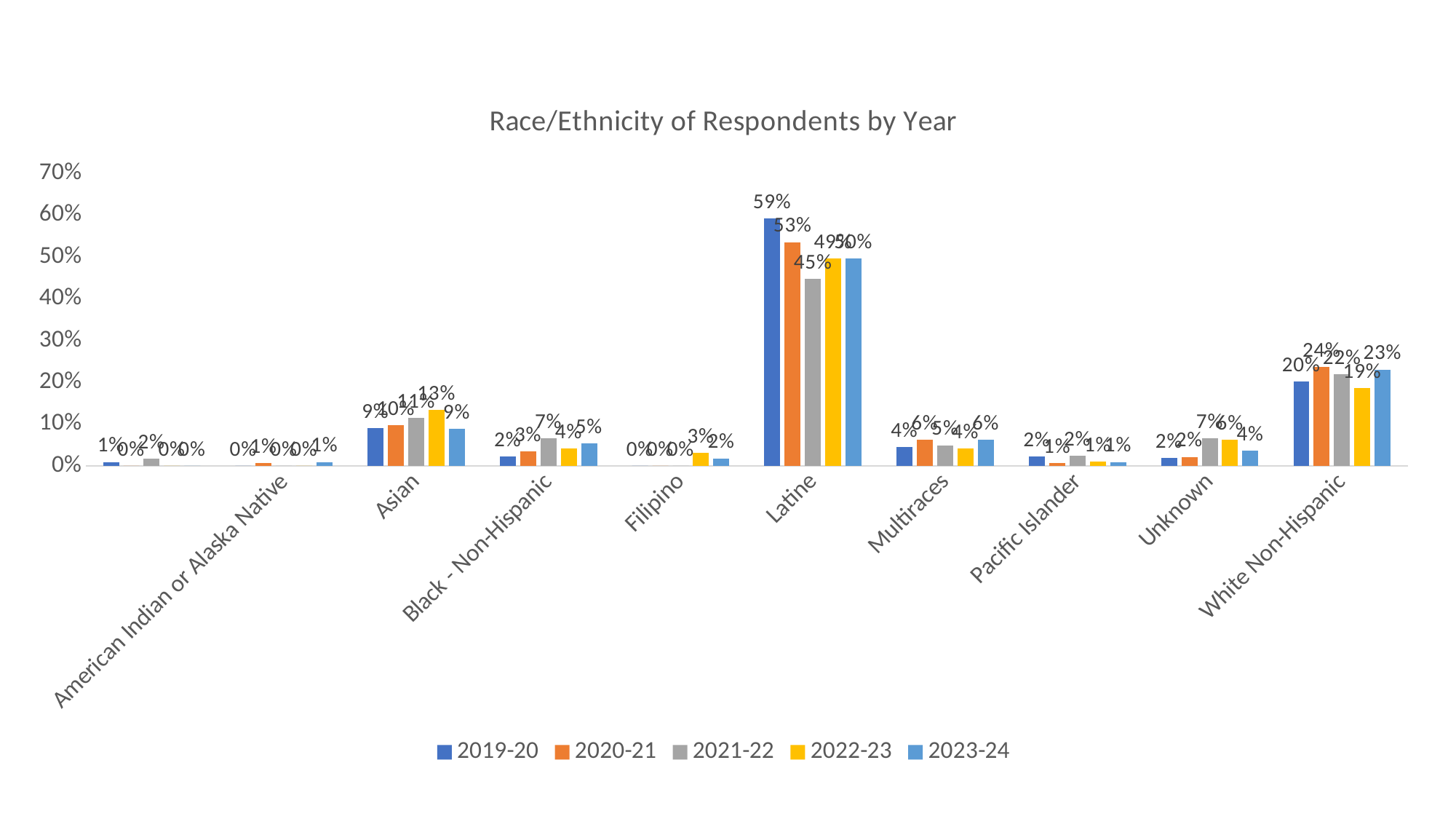
Which race/ethnicity category has the highest value in 2019-20? Latine What kind of chart is shown on the slide? bar chart What is the value for White Non-Hispanic in 2020-21? 24% What is the difference between the Latine values for 2019-20 and 2021-22? 14 percentage points What is the value for Latine in 2019-20? 59% What is the title of the chart? Race/Ethnicity of Respondents by Year Does the Latine value rise or fall from 2019-20 to 2021-22? fall What is the value for Asian in 2022-23? 13% How many series does the legend list? 5 Is the value for Latine in 2021-22 greater or less than 50%? less For White Non-Hispanic, which year has the larger value, 2022-23 or 2023-24? 2023-24 What is the value for Black - Non-Hispanic in 2021-22? 7%